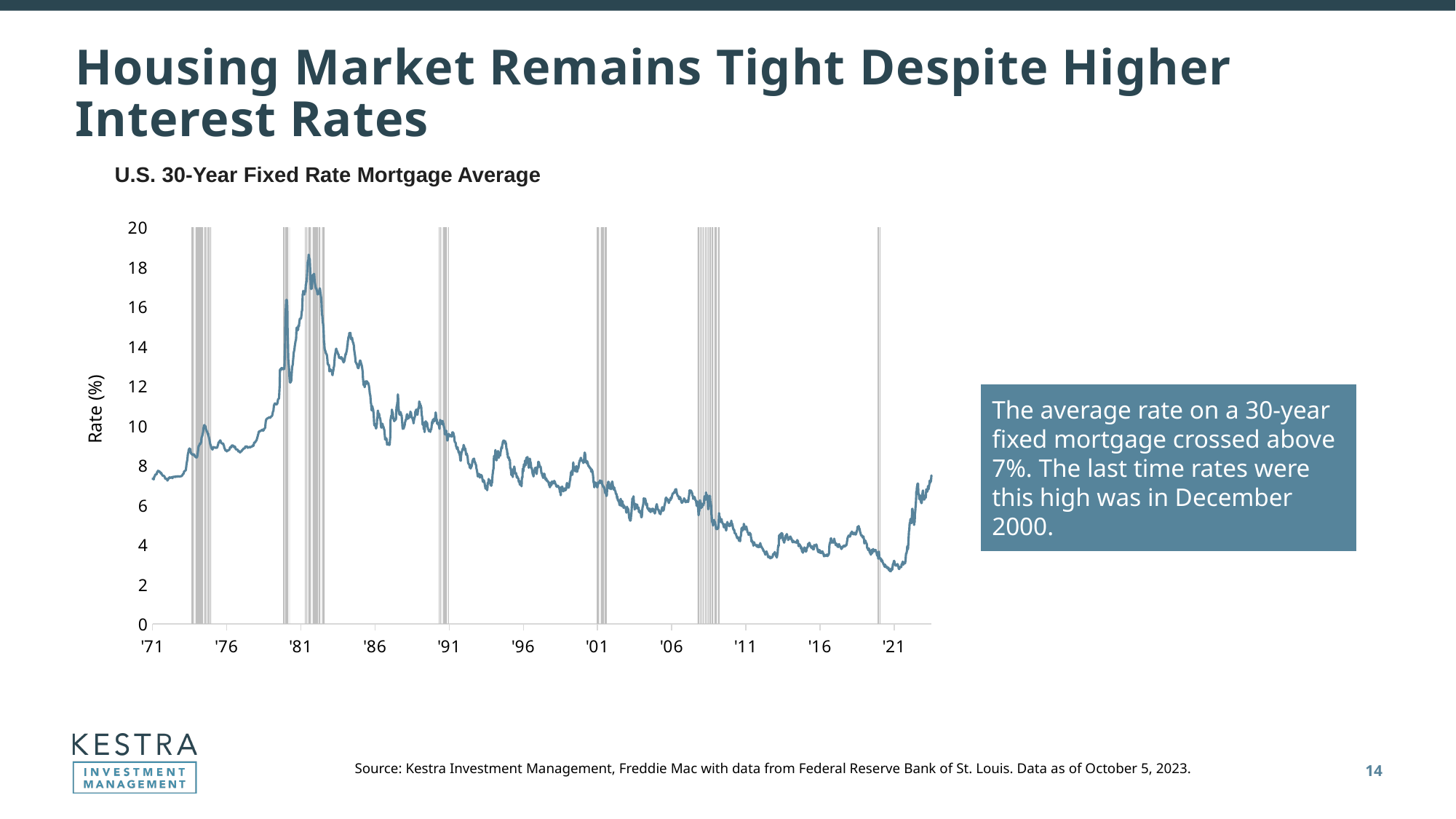
Is the mortgage rate at '71 greater or less than 10? less Near which x-axis year label does the mortgage rate line reach its lowest point? '21 Near which x-axis year label does the mortgage rate line reach its highest point? '81 What kind of chart is shown on the slide? line chart Does the mortgage rate generally rise or fall between '81 and '21? fall What is the label on the vertical axis of the chart? Rate (%) What is the title of the chart? U.S. 30-Year Fixed Rate Mortgage Average How many year labels are shown on the x axis? 11 Is the mortgage rate at '16 greater or less than 6? less Is the mortgage rate higher at '81 or at '11? '81 Is the mortgage rate at '96 greater or less than 10? less